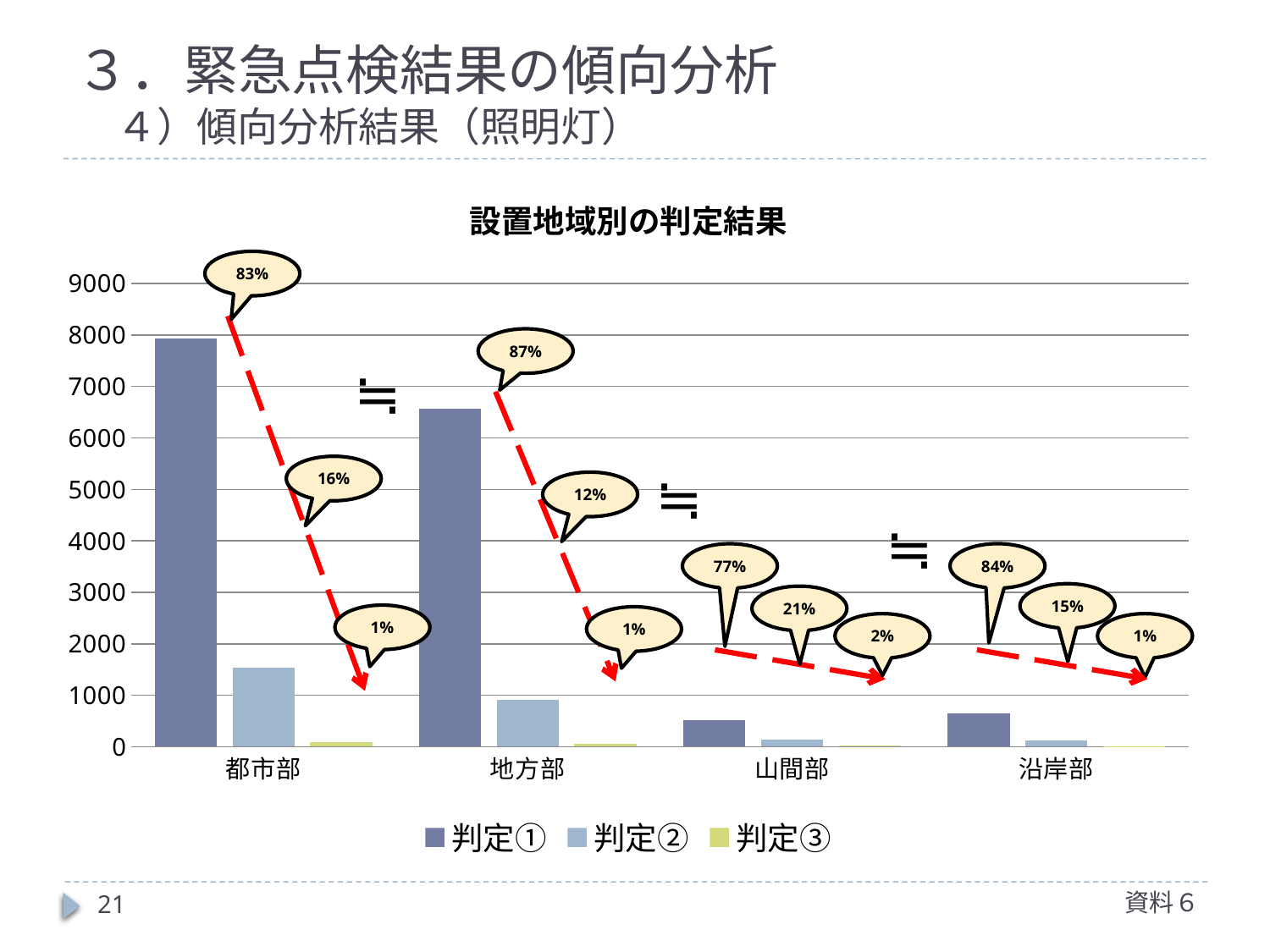
What is the title of the chart? 設置地域別の判定結果 Which is larger, the 判定① value for 都市部 or for 地方部? 都市部 Is the 判定② value for 都市部 greater or less than 1000? greater Is the 判定① value for 都市部 greater or less than 7000? greater How many series does the legend list? 3 Which category has the lowest 判定① bar? 山間部 What percentage is shown in the callout above the 判定① bar for 地方部? 87% Is the 判定① value for 地方部 greater or less than 7000? less How many categories are shown on the x axis? 4 What kind of chart is shown on the slide? bar chart Which category has the highest 判定① bar? 都市部